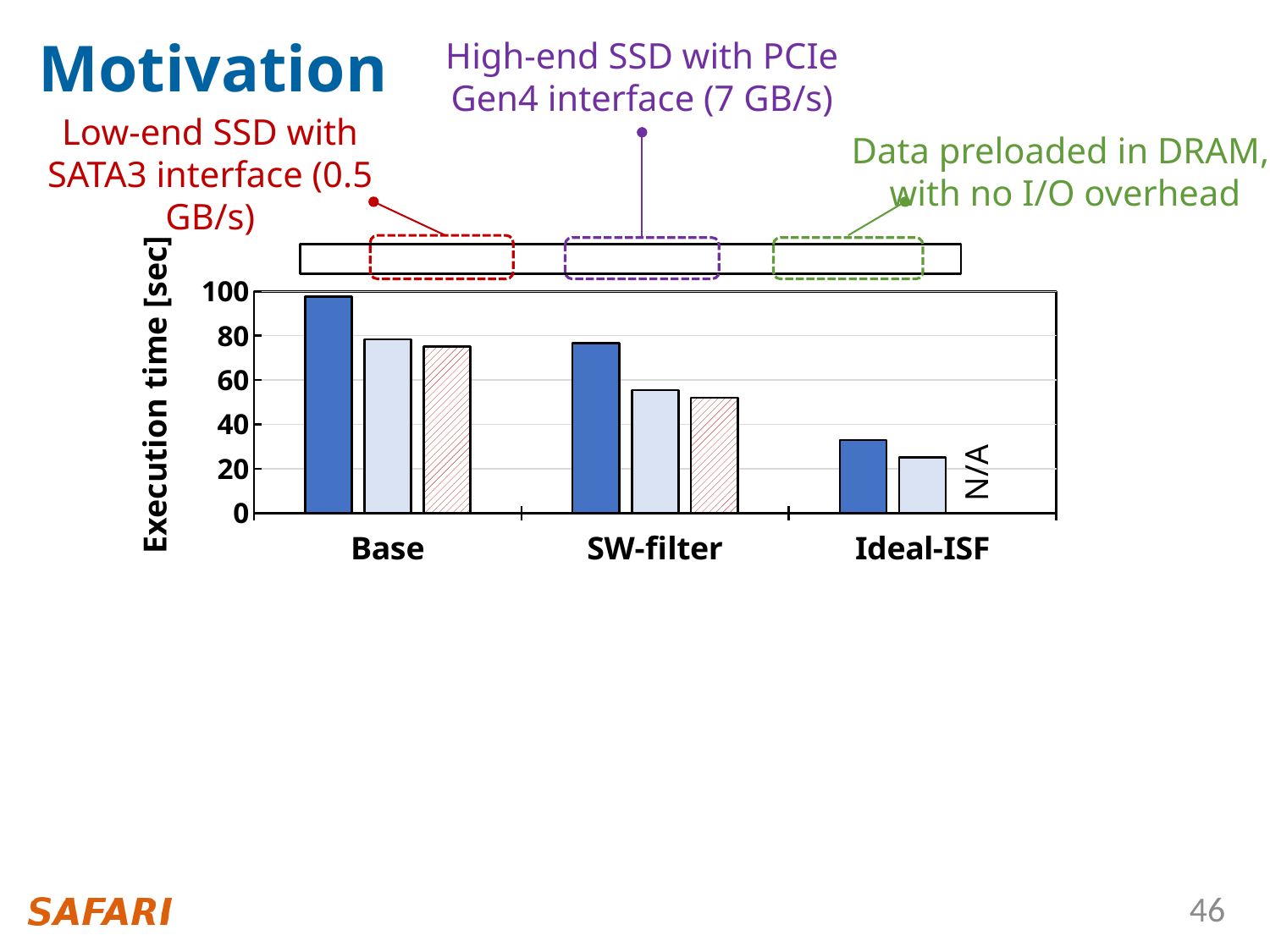
What is the y-axis title of the chart? Execution time [sec] Is the value of the dark blue bar for Base greater or less than 80? greater Which is larger: the dark blue bar for Base or the dark blue bar for SW-filter? Base What label is shown in place of the third bar for Ideal-ISF? N/A How many categories are shown on the x axis of the chart? 3 Is the value of the dark blue bar for Ideal-ISF greater or less than 40? less Is the value of the light blue bar for SW-filter greater or less than 60? less Do the dark blue bars rise or fall from Base to Ideal-ISF along the x axis? fall Which category has the tallest bar in the chart? Base Which category has the shortest bars in the chart? Ideal-ISF What kind of chart is shown on the slide? bar chart